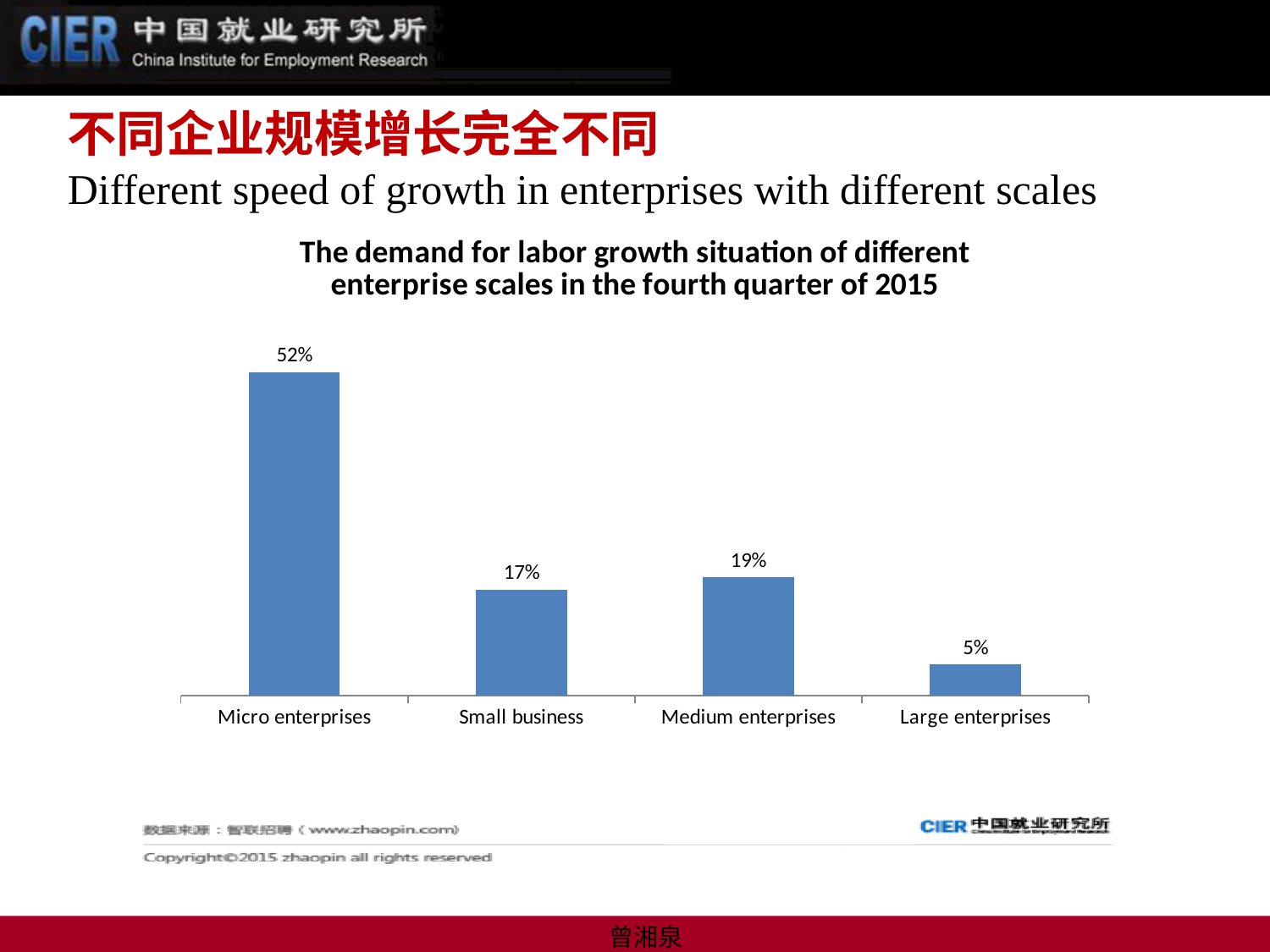
Which category has the highest value? Micro enterprises What kind of chart is shown on the slide? Bar chart How many categories are shown on the x axis? 4 What is the difference between the values for Micro enterprises and Large enterprises? 47% Which is larger, the value for Small business or the value for Medium enterprises? Medium enterprises What is the title of the chart? The demand for labor growth situation of different enterprise scales in the fourth quarter of 2015 What is the value for Medium enterprises? 19% Which category has the lowest value? Large enterprises What is the value for Micro enterprises? 52% What is the value for Small business? 17% What is the value for Large enterprises? 5% What is the difference between the values for Medium enterprises and Small business? 2%